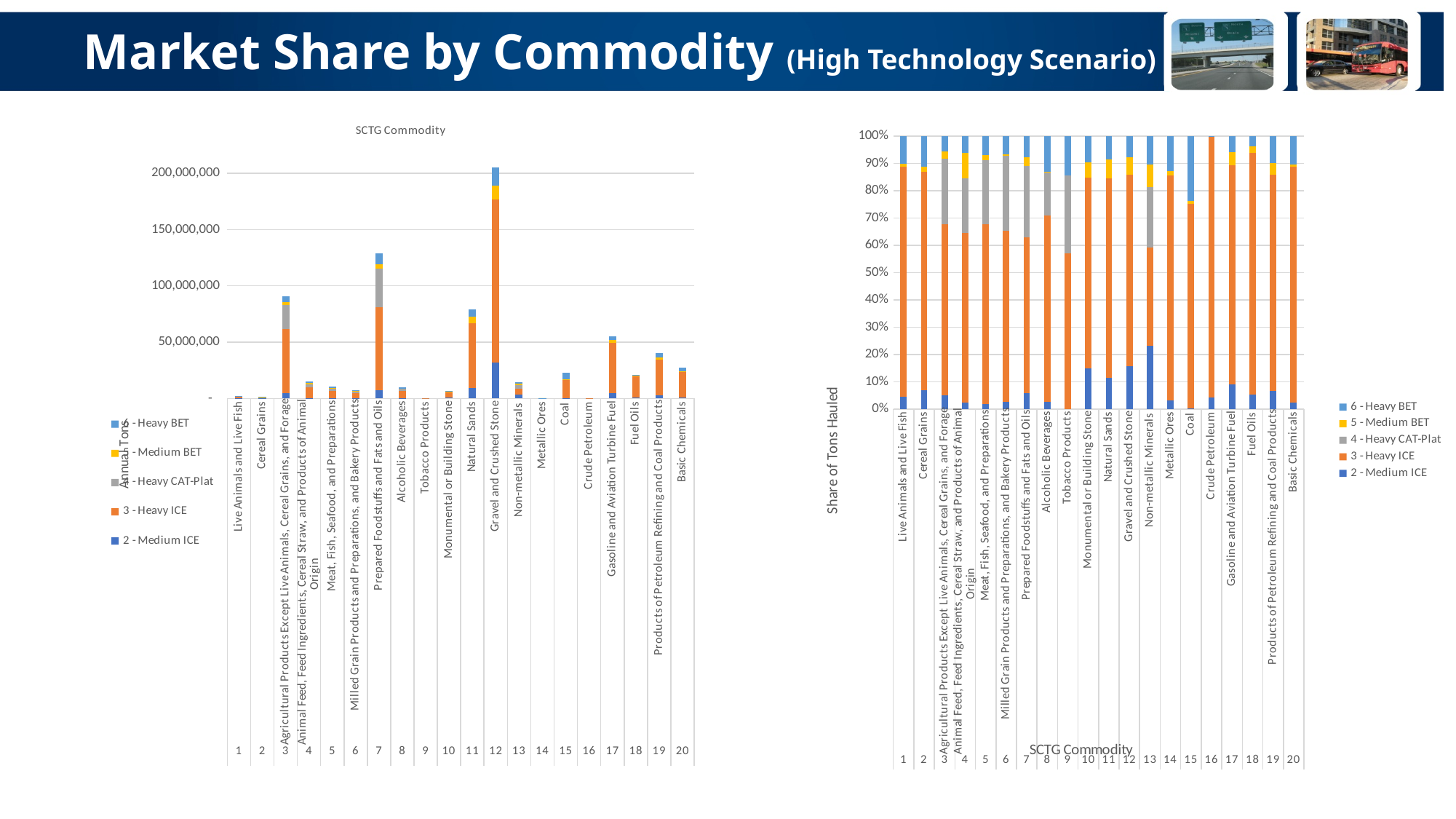
What is the y-axis label of the right chart? Share of Tons Hauled On the right chart (Share of Tons Hauled), is the share of 2 - Medium ICE for Non-metallic Minerals greater or less than 10%? greater On the left chart (SCTG Commodity), which has a larger total: Gravel and Crushed Stone or Natural Sands? Gravel and Crushed Stone On the left chart (SCTG Commodity), is the total for Gasoline and Aviation Turbine Fuel greater or less than 100,000,000? less How many series does the legend of the right chart (Share of Tons Hauled) list? 5 On the left chart (SCTG Commodity), is the total for Prepared Foodstuffs and Fats and Oils greater or less than 100,000,000? greater How many commodity categories are plotted on the left chart (SCTG Commodity)? 20 What kind of chart is the left chart titled "SCTG Commodity"? Stacked bar chart Which legend entry is shown in grey on both charts? 4 - Heavy CAT-Plat On the left chart (SCTG Commodity), which commodity has the highest total annual tons? Gravel and Crushed Stone